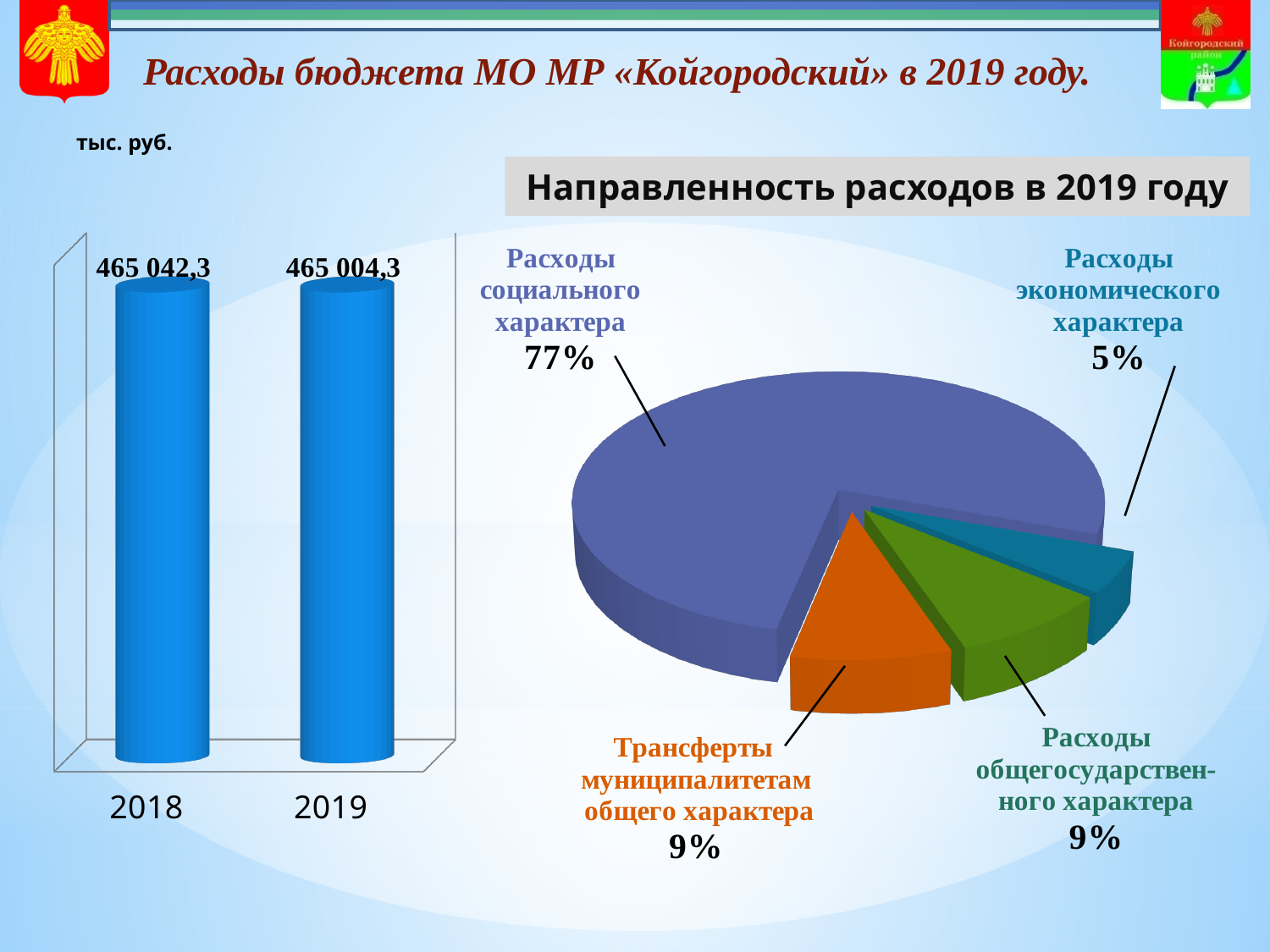
On the pie chart 'Направленность расходов в 2019 году', how many slices are there? 4 On the pie chart 'Направленность расходов в 2019 году', which category has the smallest share? Расходы экономического характера On the bar chart on the left, what is the value for 2018? 465 042,3 On the pie chart 'Направленность расходов в 2019 году', which category has the largest share? Расходы социального характера What kind of chart is the chart on the left of the slide? Bar chart On the pie chart 'Направленность расходов в 2019 году', what share is 'Расходы социального характера'? 77% On the bar chart on the left, how many bars are shown? 2 On the pie chart 'Направленность расходов в 2019 году', what share is 'Расходы экономического характера'? 5% On the pie chart 'Направленность расходов в 2019 году', what is the difference between the shares of 'Расходы социального характера' and 'Расходы экономического характера'? 72% On the bar chart on the left, what is the difference between the 2018 and 2019 values? 38,0 On the bar chart on the left, what is the value for 2019? 465 004,3 On the pie chart 'Направленность расходов в 2019 году', what share is 'Трансферты муниципалитетам общего характера'? 9%